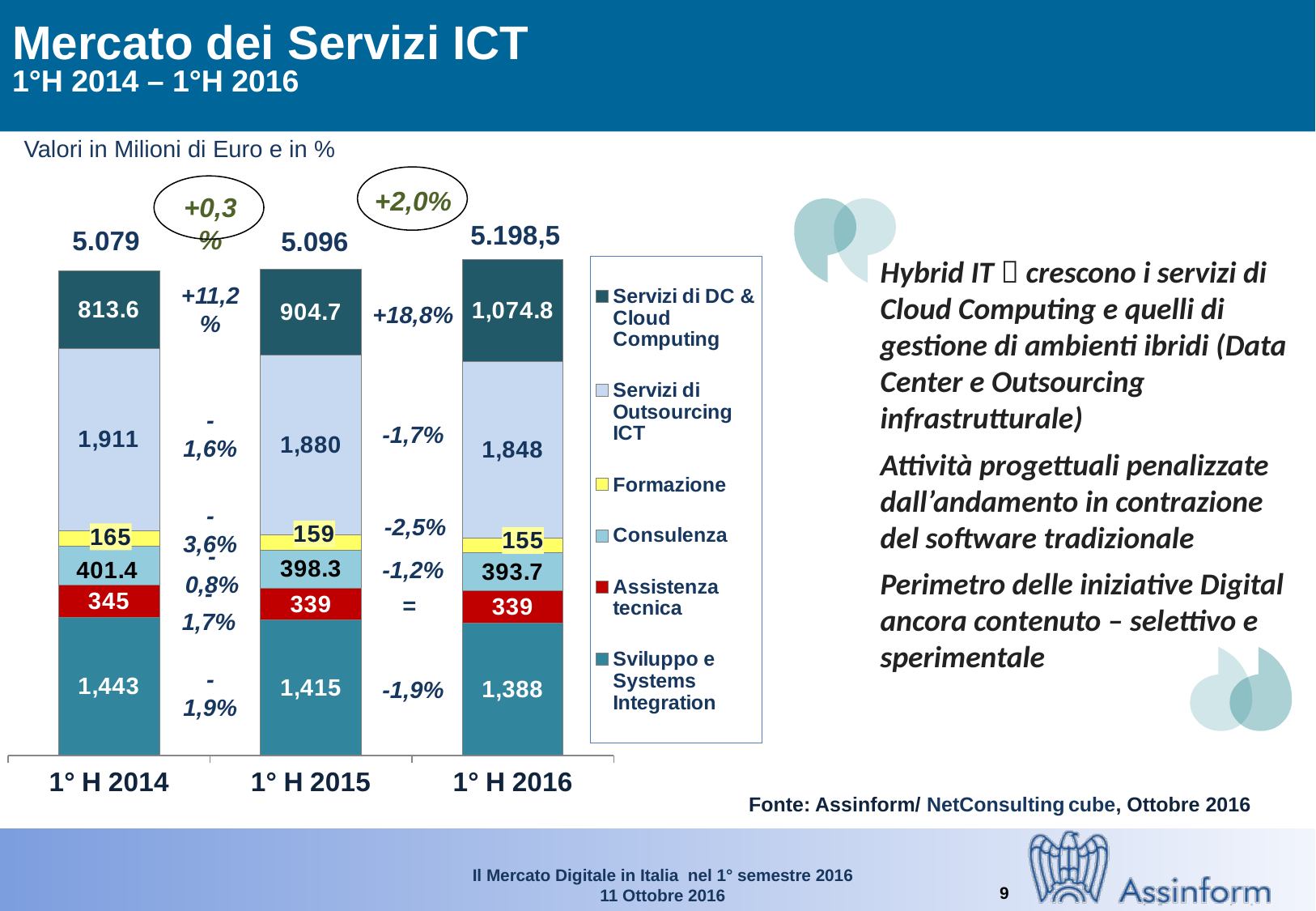
How many series does the legend list? 6 What is the value for Sviluppo e Systems Integration in 1° H 2014? 1,443 What is the value for Consulenza in 1° H 2016? 393.7 Which segment is the smallest in the 1° H 2016 bar? Formazione What is the value for Servizi di DC & Cloud Computing in 1° H 2016? 1,074.8 What is the difference between Servizi di Outsourcing ICT in 1° H 2014 and in 1° H 2016? 63 Does the value for Servizi di DC & Cloud Computing rise or fall from 1° H 2014 to 1° H 2016? rise How many periods (bars) are shown on the x axis? 3 What is the value for Formazione in 1° H 2015? 159 Which period has the highest total value? 1° H 2016 What is the total shown above the 1° H 2016 bar? 5.198,5 In 1° H 2014, which is larger: Consulenza or Assistenza tecnica? Consulenza